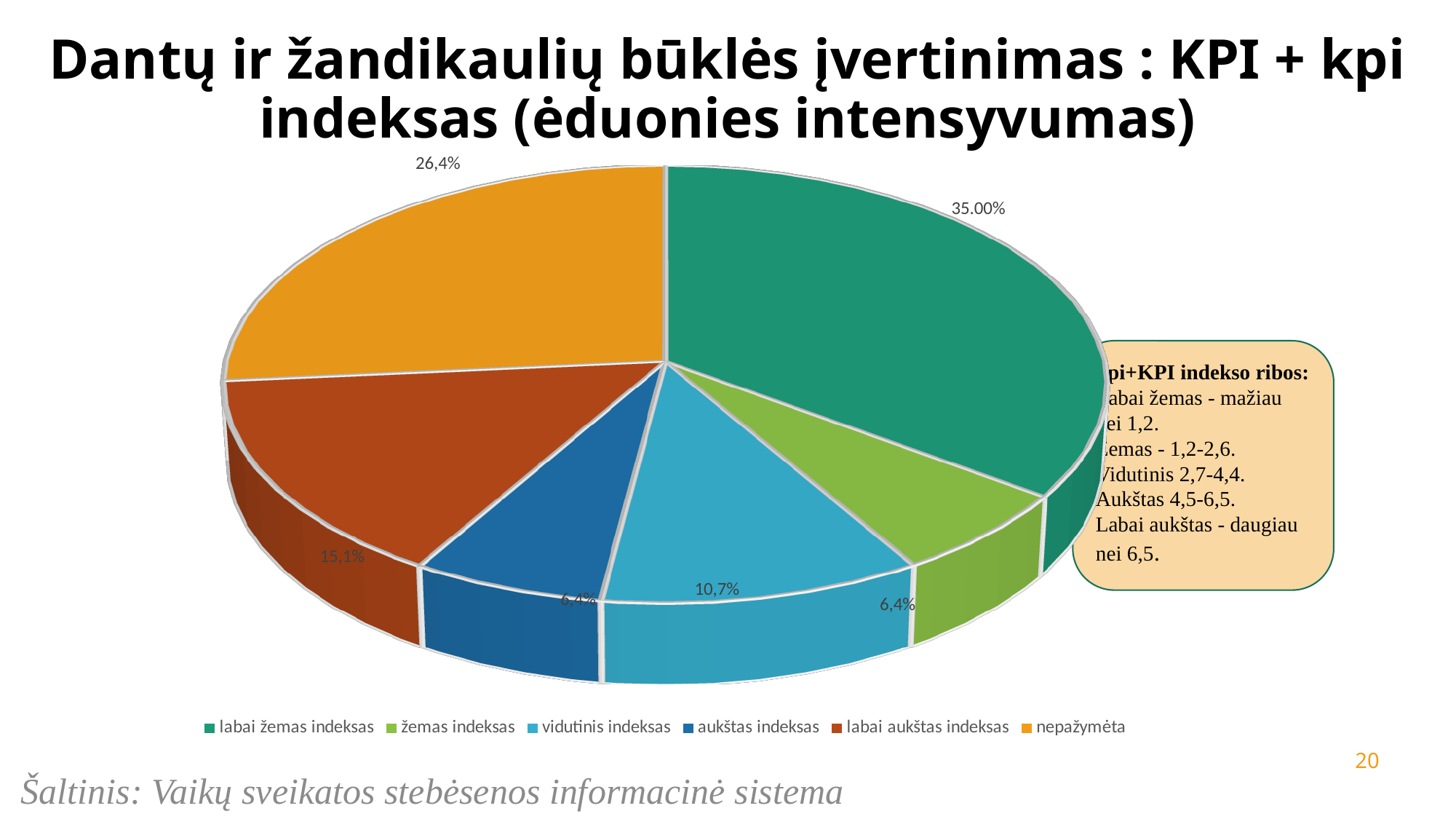
What share of the pie does 'labai žemas indeksas' have? 35.00% What colour is the slice for 'nepažymėta'? orange What is the value shown for 'labai aukštas indeksas'? 15,1% What is the difference between the 'labai aukštas indeksas' share and the 'vidutinis indeksas' share? 4,4% How many categories does the legend list? 6 What kind of chart is shown on the slide? pie chart What is the value shown for 'nepažymėta'? 26,4% Which is larger, the slice for 'nepažymėta' or the slice for 'labai aukštas indeksas'? nepažymėta Which category has the largest slice of the pie? labai žemas indeksas What is the value shown for 'vidutinis indeksas'? 10,7% What is the difference between the 'labai žemas indeksas' share and the 'nepažymėta' share? 8,6% What is the value shown for 'žemas indeksas'? 6,4%